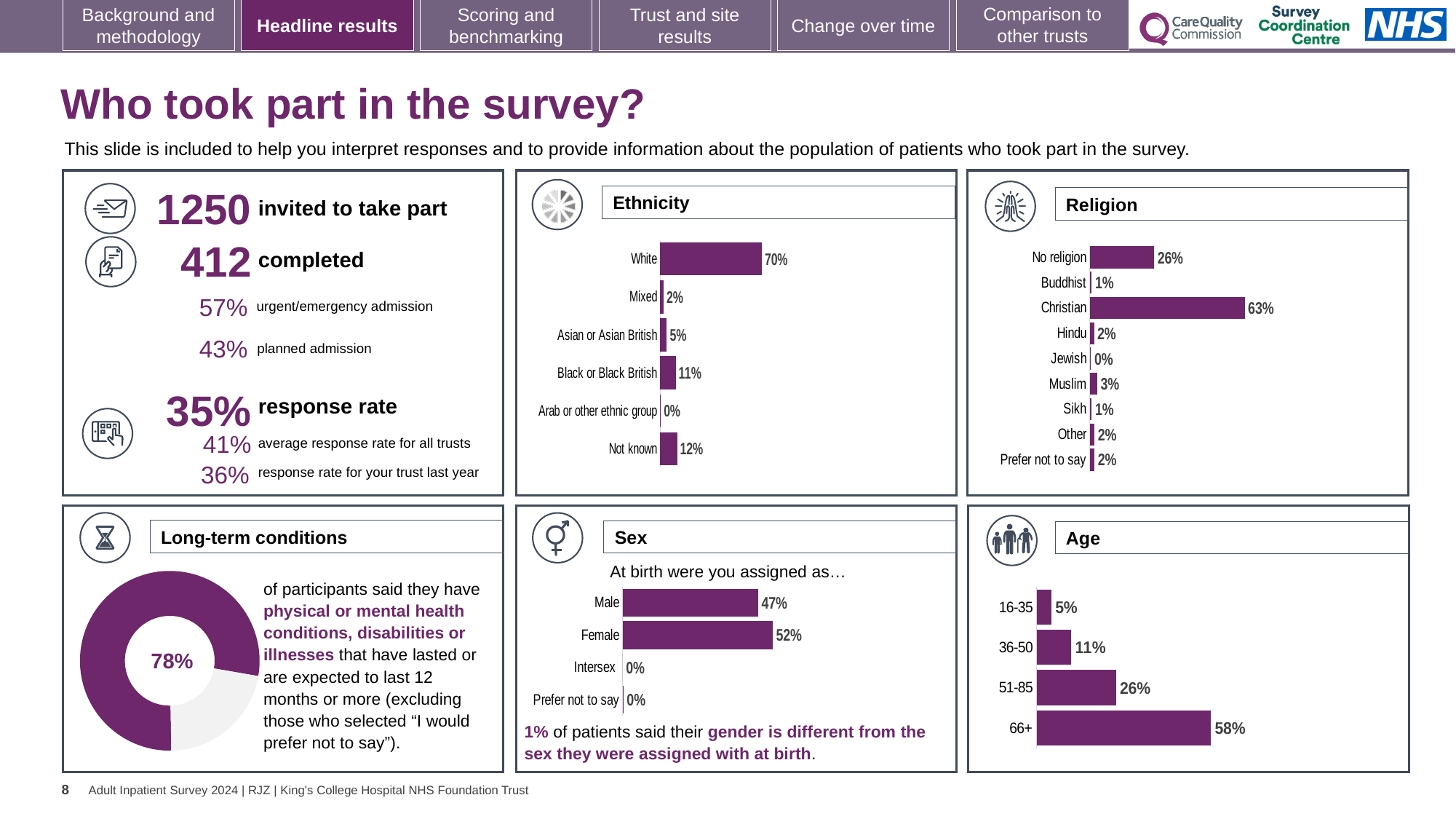
In the Age chart, what percentage of respondents were aged 66+? 58% In the Religion chart, what percentage of respondents were Christian? 63% In the Religion chart, which category has the lowest value? Jewish In the Ethnicity chart, what is the difference between the Not known and Black or Black British values? 1% In the Age chart, do the values rise or fall as age increases from 16-35 to 66+? rise In the Sex chart, which is larger, Male or Female? Female What kind of chart is the Long-term conditions chart? doughnut chart How many categories are shown in the Religion chart? 9 In the Ethnicity chart, which category has the highest value? White In the Sex chart, what is the difference between the Female and Male values? 5% In the Long-term conditions chart, what share of participants said they have long-term conditions? 78% In the Ethnicity chart, what percentage of respondents were White? 70%